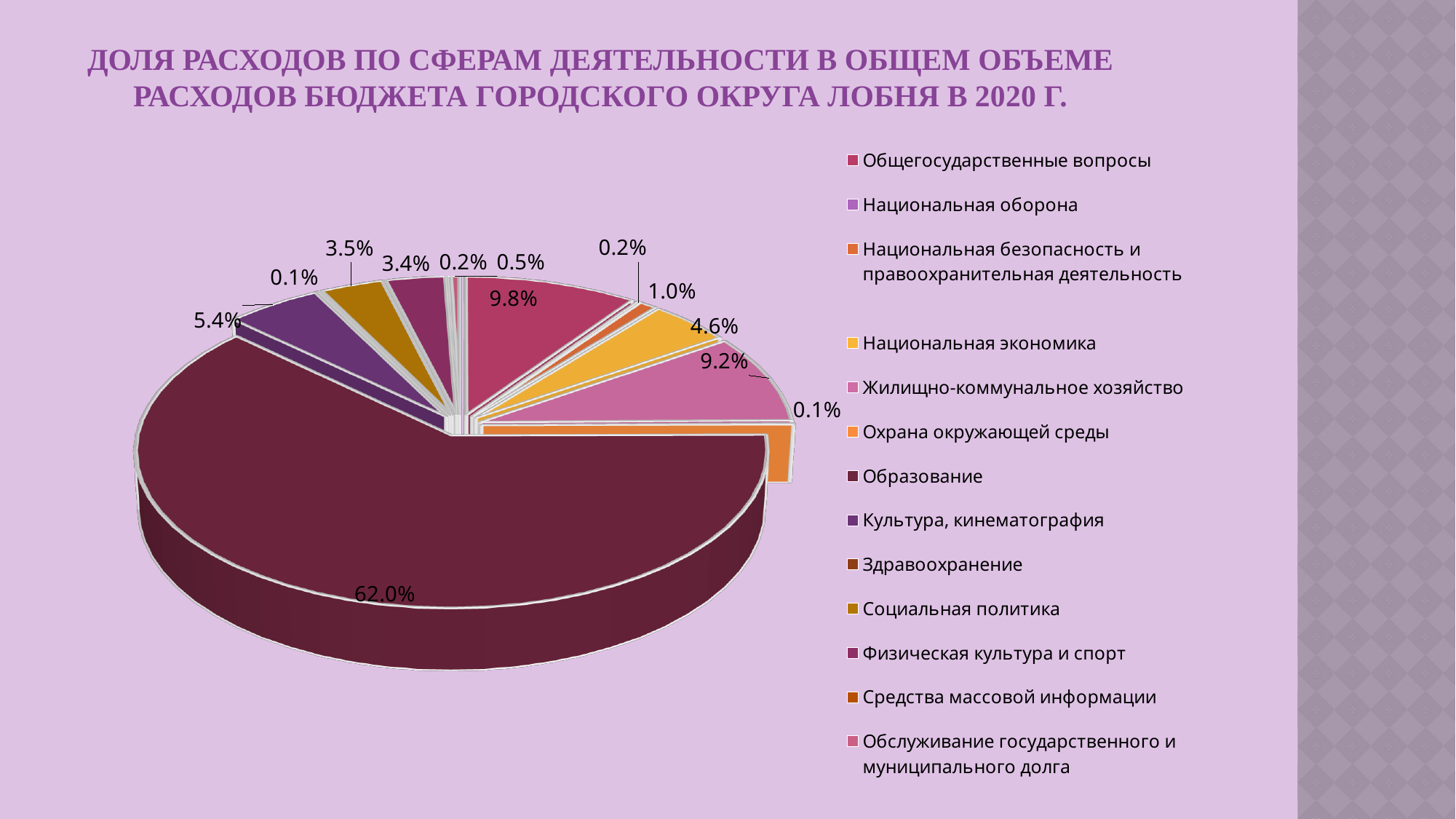
What share of expenditures does Образование account for? 62.0% What is the share for Социальная политика? 3.5% What year does the chart title refer to? 2020 What is the value shown for Общегосударственные вопросы? 9.8% Which category has the largest share of the budget expenditures? Образование Which is larger: the share for Культура, кинематография or for Национальная экономика? Культура, кинематография How many categories does the legend list? 13 What value is shown for Культура, кинематография? 5.4% What percentage is shown for Жилищно-коммунальное хозяйство? 9.2% What is the share for Национальная экономика? 4.6% What is the difference between the shares of Общегосударственные вопросы and Жилищно-коммунальное хозяйство? 0.6 percentage points What kind of chart is shown on the slide? Pie chart